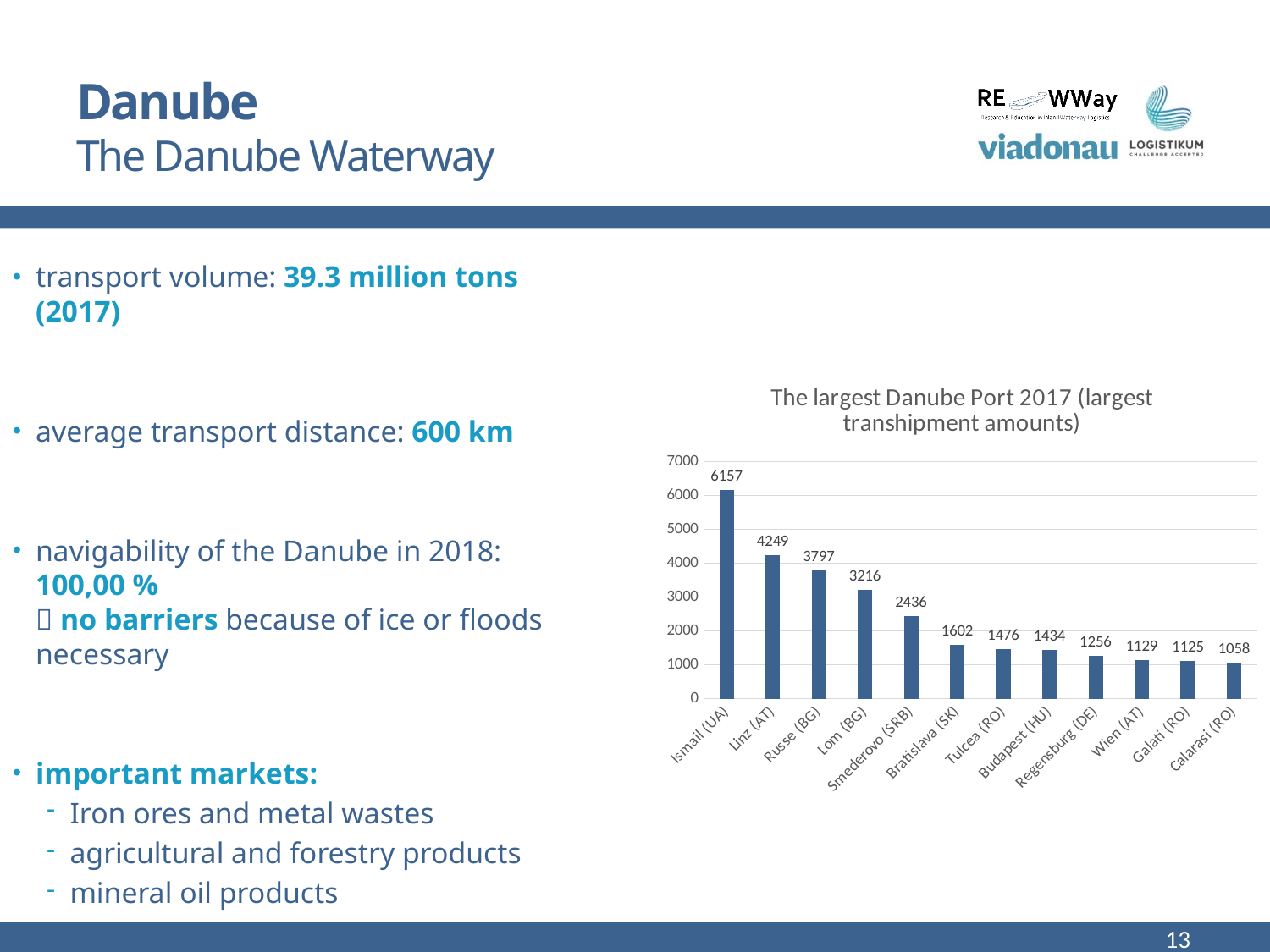
What is the title of the chart? The largest Danube Port 2017 (largest transhipment amounts) What kind of chart is shown on the slide? bar chart What is the value for Regensburg (DE)? 1256 What is the value for Ismail (UA)? 6157 What is the value for Smederovo (SRB)? 2436 Which port has the highest value? Ismail (UA) How many ports are shown in the chart? 12 Which port has the lowest value? Calarasi (RO) Is the value for Tulcea (RO) greater or less than 2000? less Do the values rise or fall from left to right along the x axis? fall What is the difference between the values for Linz (AT) and Russe (BG)? 452 Which is larger, the value for Lom (BG) or the value for Bratislava (SK)? Lom (BG)